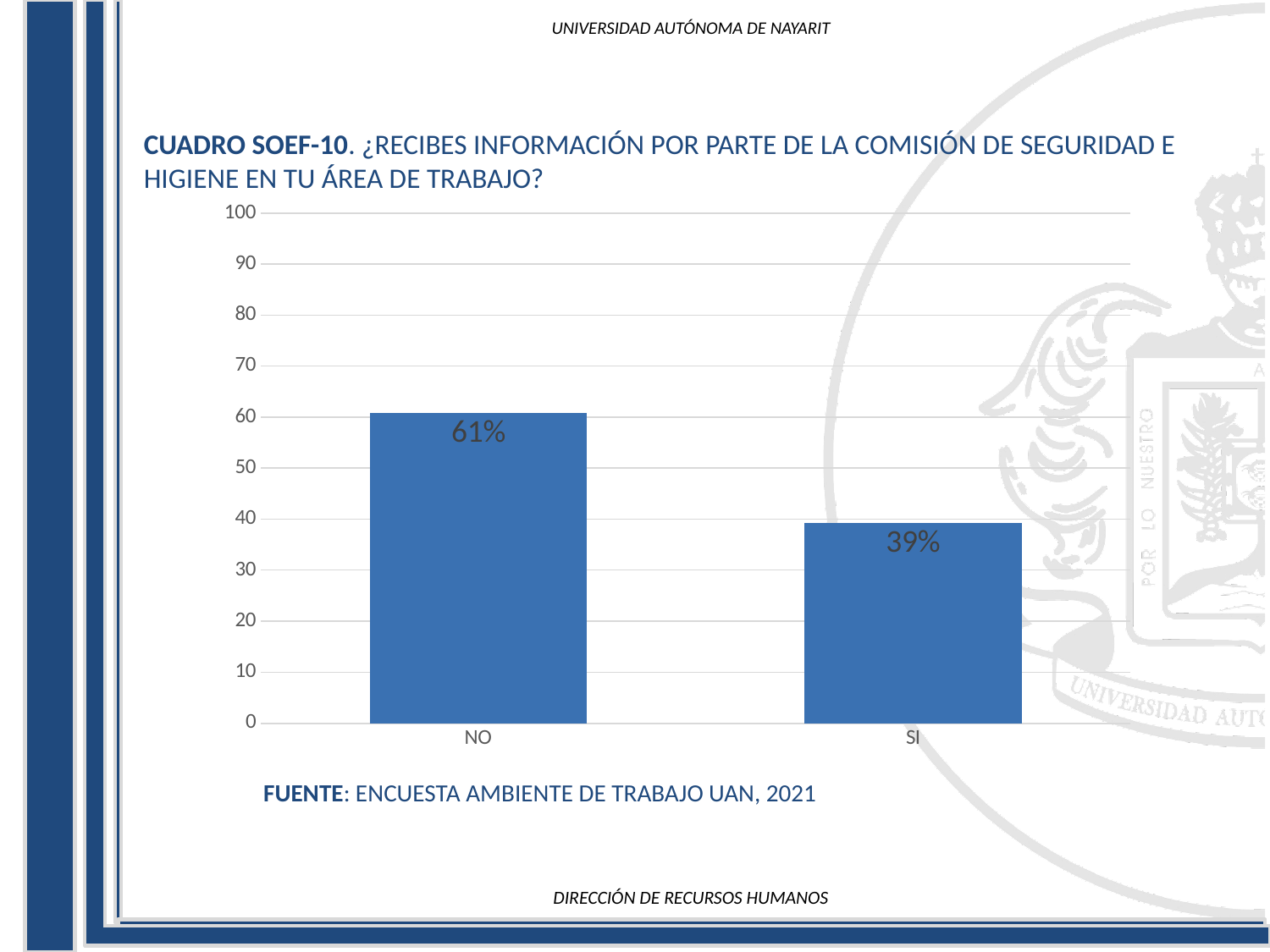
What is the value for NO? 61% How many categories are shown on the x axis? 2 Which category has the highest value? NO Which category has the lowest value? SI What kind of chart is shown on the slide? bar chart Is the value for SI greater or less than 50? less Which is larger, the value for NO or the value for SI? NO What source is cited below the chart? ENCUESTA AMBIENTE DE TRABAJO UAN, 2021 What is the difference between the values for NO and SI? 22% Is the value for NO greater or less than 50? greater What is the value for SI? 39% What is the maximum value shown on the y axis? 100